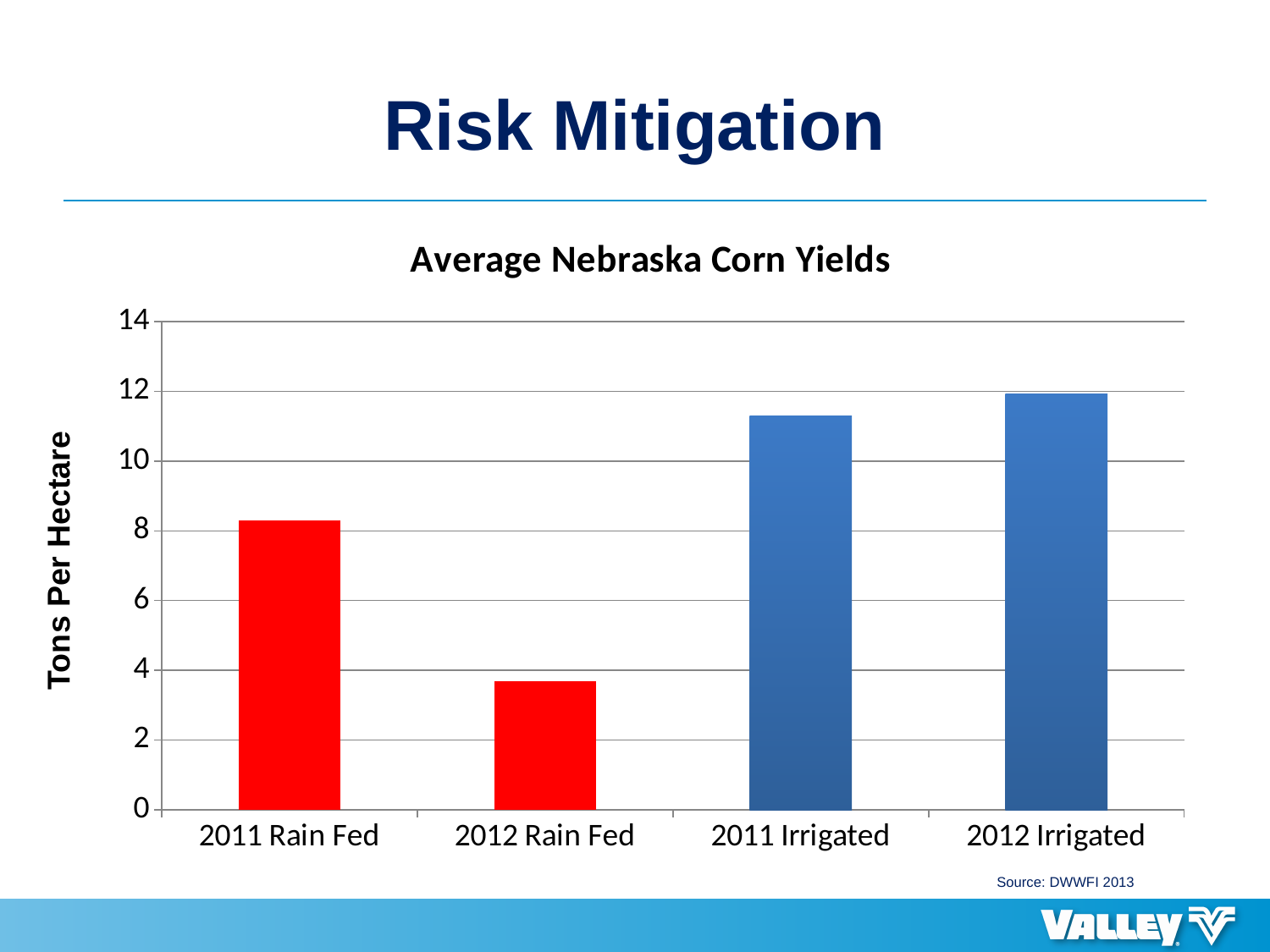
How many categories are shown on the x axis? 4 What type of chart is shown on the slide? bar chart Which category has the highest value? 2012 Irrigated Which category has the lowest value? 2012 Rain Fed What is the label of the vertical axis? Tons Per Hectare Is the value for 2011 Irrigated greater or less than 10? greater Is the value for 2012 Irrigated greater or less than 10? greater Is the value for 2011 Rain Fed greater or less than 10? less Which is larger, the value for 2011 Rain Fed or the value for 2012 Rain Fed? 2011 Rain Fed Which is larger, the value for 2012 Rain Fed or the value for 2011 Irrigated? 2011 Irrigated What is the title of the chart? Average Nebraska Corn Yields